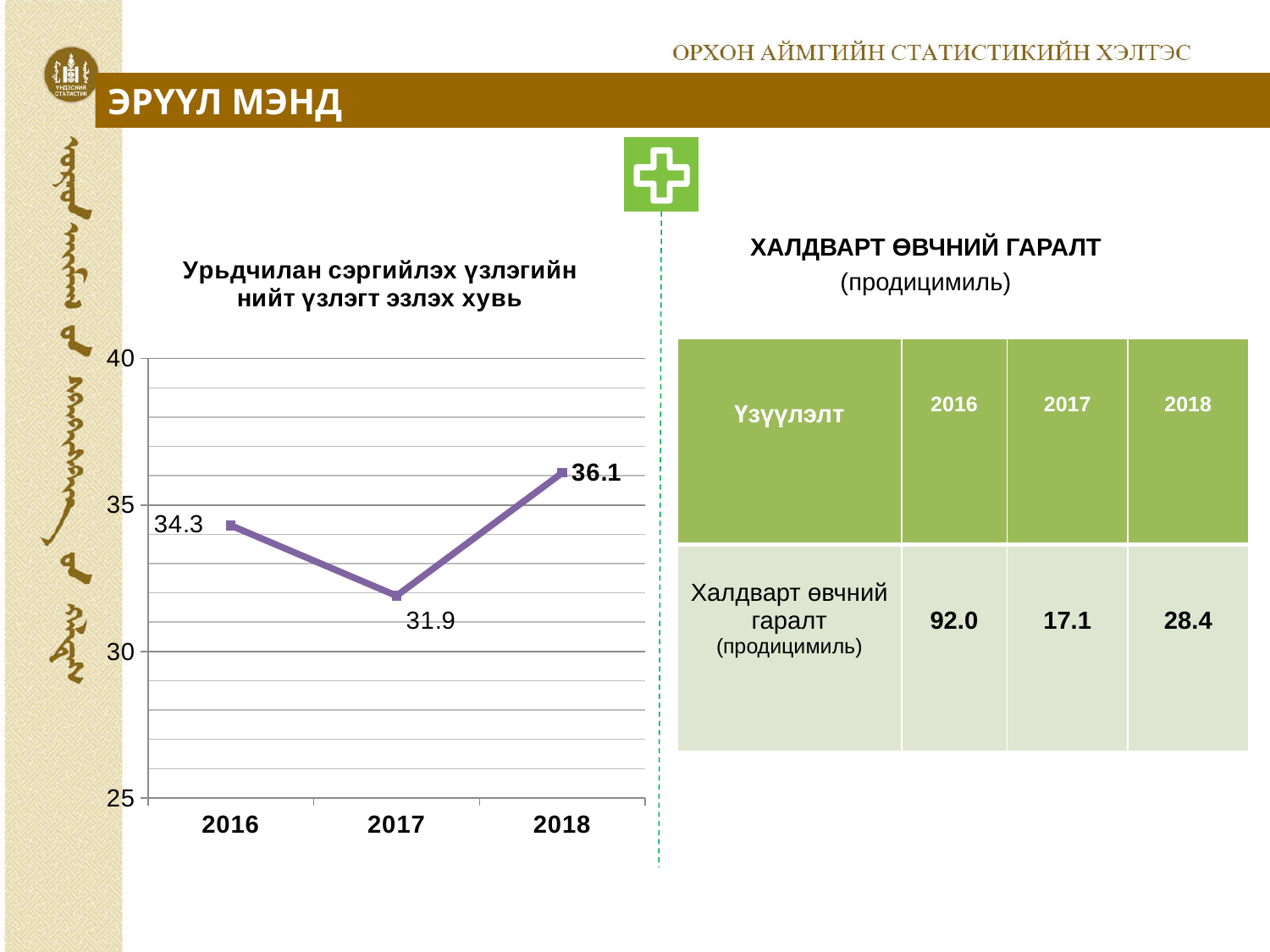
How many years are plotted on the x axis of the line chart? 3 What is the value for 2017 in the line chart? 31.9 What is the difference between the 2018 and 2017 values in the line chart? 4.2 What is the difference between the 2016 and 2017 values in the line chart? 2.4 Which year has the lowest value in the line chart? 2017 Which year has the highest value in the line chart? 2018 What type of chart is shown on the slide? Line chart What is the title of the line chart? Урьдчилан сэргийлэх үзлэгийн нийт үзлэгт эзлэх хувь What is the value for 2018 in the line chart? 36.1 Is the value for 2017 in the line chart greater or less than 35? less What is the value for 2016 in the line chart? 34.3 Which is larger in the line chart, the value for 2016 or the value for 2018? 2018